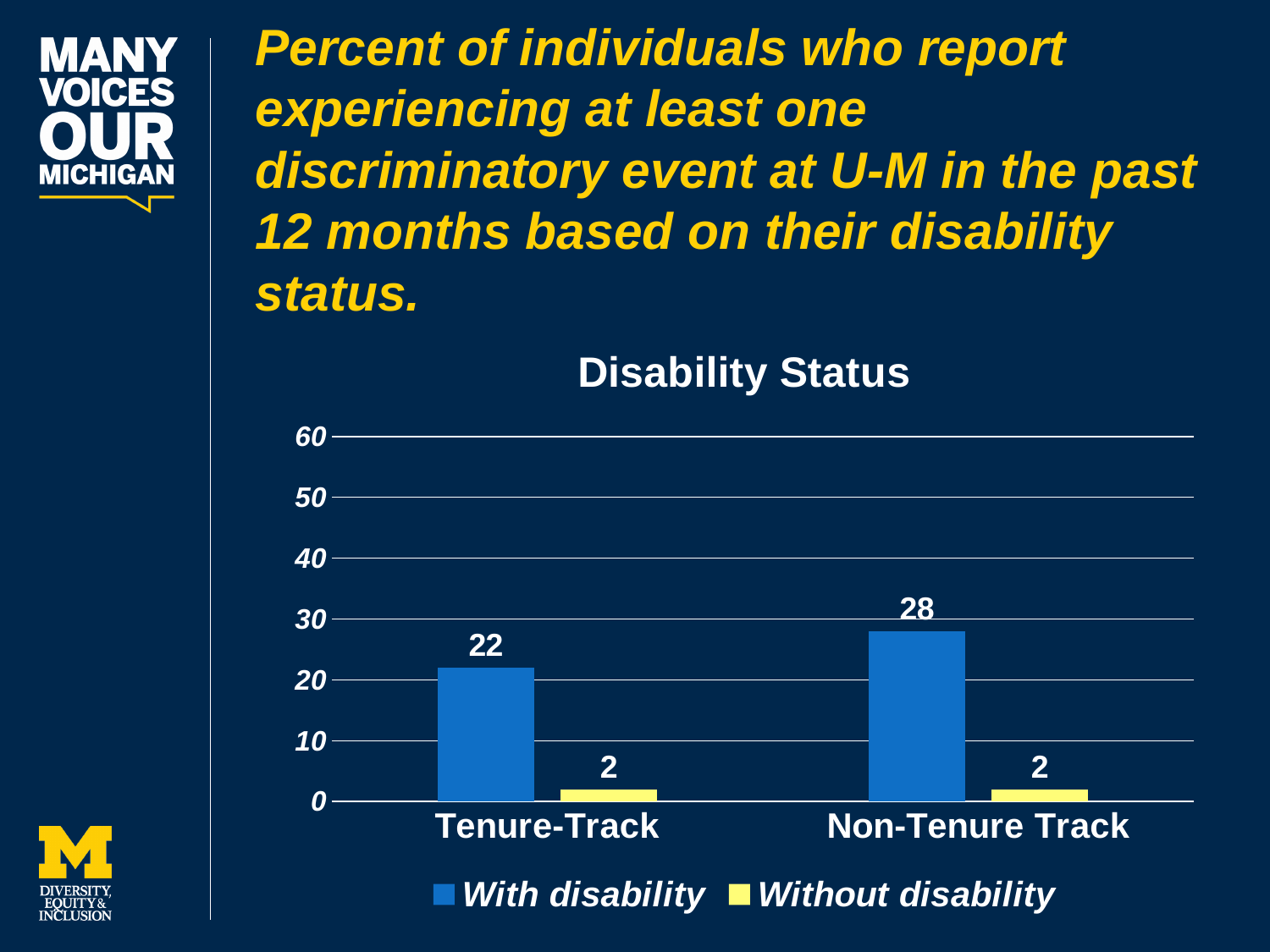
In the Tenure-Track category, what is the difference between the With disability and Without disability values? 20 What is the value for Without disability in the Tenure-Track category? 2 What is the difference between the With disability values for Non-Tenure Track and Tenure-Track? 6 What is the value for With disability in the Tenure-Track category? 22 What is the value for Without disability in the Non-Tenure Track category? 2 Which is larger in the Non-Tenure Track category: With disability or Without disability? With disability What is the value for With disability in the Non-Tenure Track category? 28 How many categories are shown on the x axis? 2 What type of chart is shown? Bar chart How many series does the legend list? 2 Is the value for With disability in Non-Tenure Track greater or less than 30? less Which category has the highest value for With disability? Non-Tenure Track